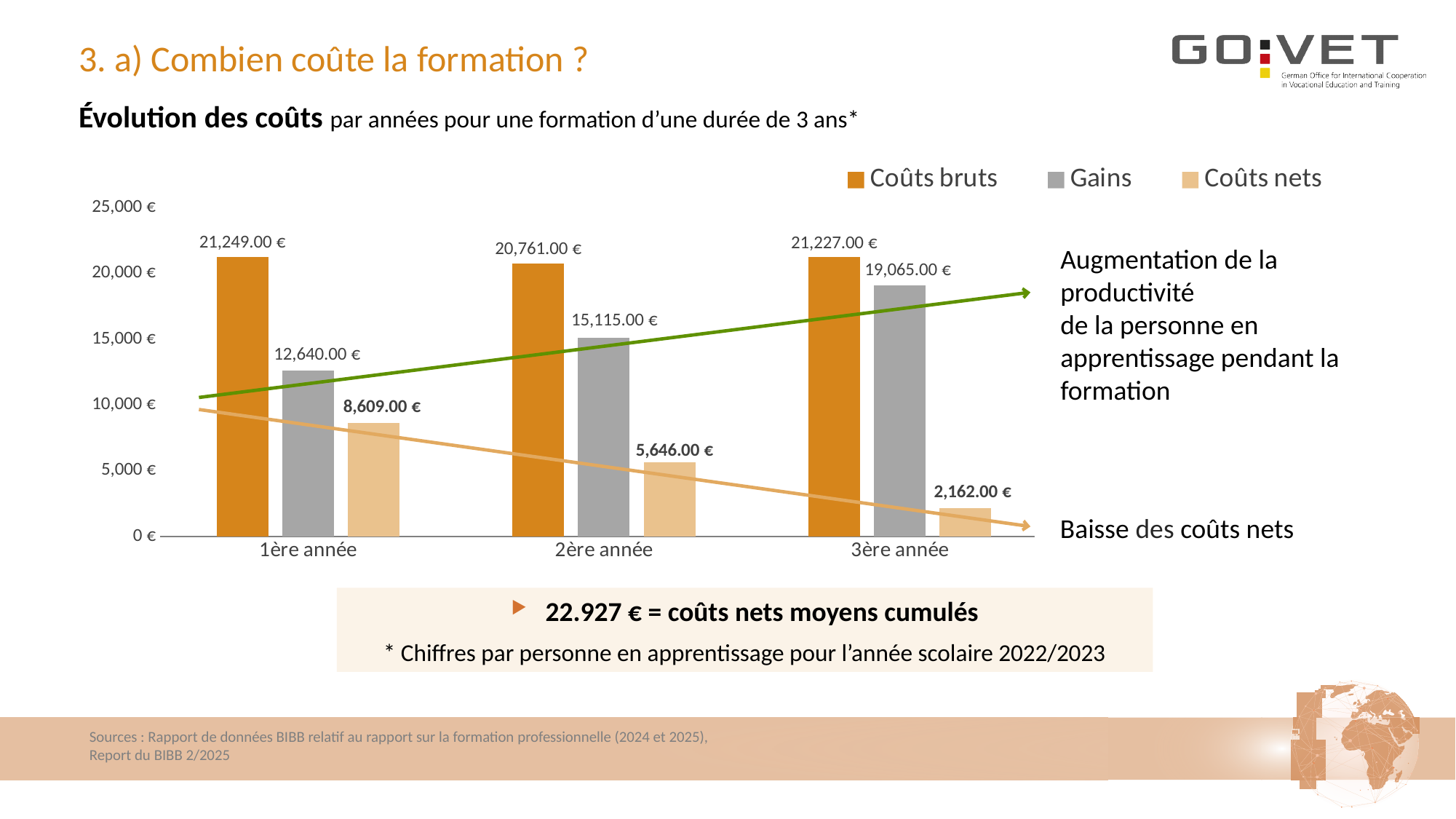
Which year has the highest Gains? 3ère année Which year has the lowest Coûts nets? 3ère année What kind of chart is shown on the slide? bar chart Which is larger for 1ère année: Gains or Coûts nets? Gains What is the value of Coûts nets for 2ère année? 5,646.00 € How many series does the legend list? 3 Is the value of Gains for 1ère année greater or less than 15,000 €? less What is the value of Gains for 3ère année? 19,065.00 € What is the value of Coûts bruts for 1ère année? 21,249.00 € Do the Coûts nets values rise or fall from 1ère année to 3ère année? fall How many year categories are shown on the x axis? 3 What is the difference between Coûts bruts and Gains for 2ère année? 5,646.00 €